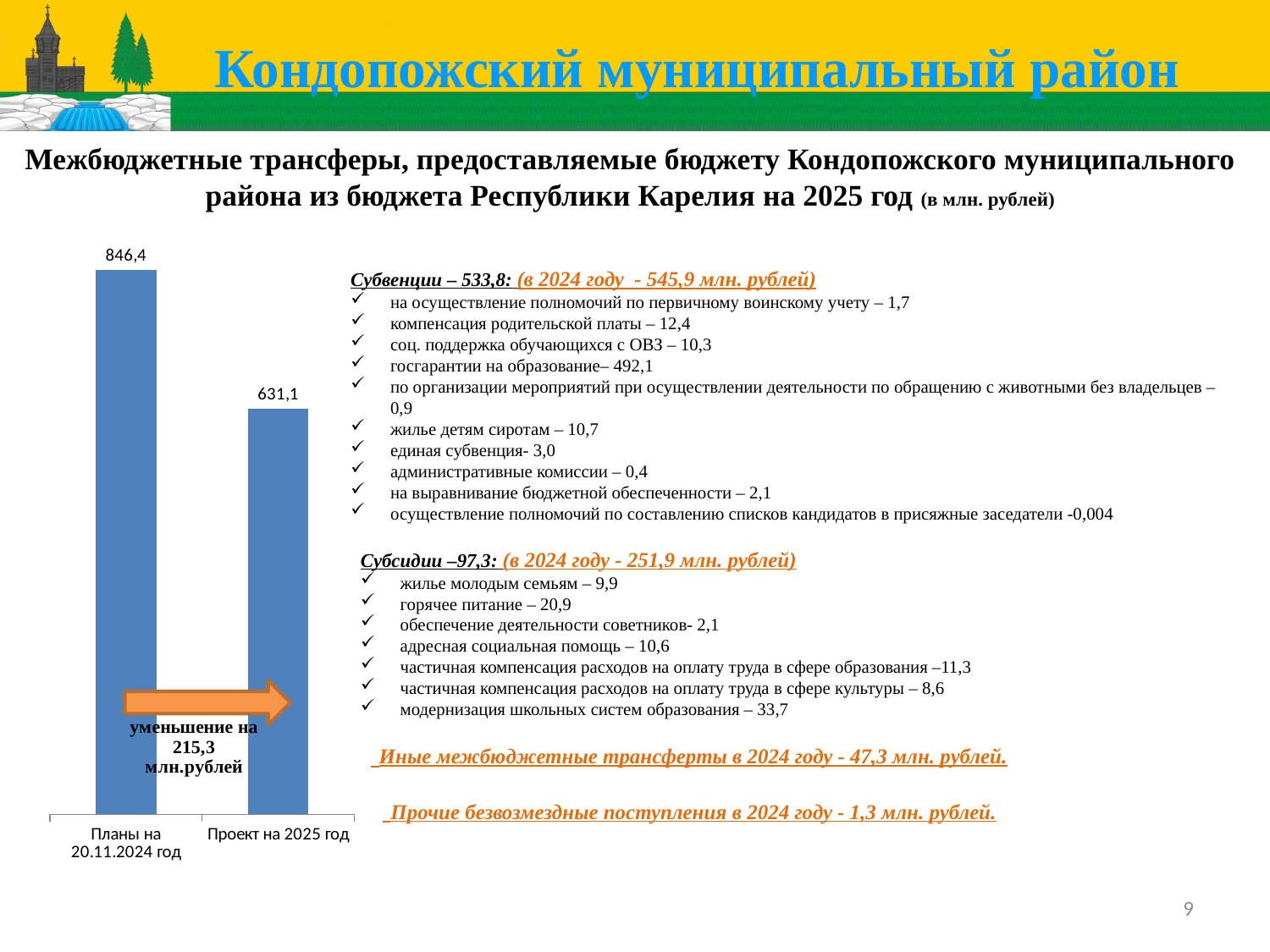
Which category has the highest value? Планы на 20.11.2024 год What is the value for "Проект на 2025 год"? 631,1 What kind of chart is shown on the slide? Bar chart What is the difference between the value for "Планы на 20.11.2024 год" and the value for "Проект на 2025 год"? 215,3 Do the values rise or fall from "Планы на 20.11.2024 год" to "Проект на 2025 год"? Fall Which category has the lowest value? Проект на 2025 год What decrease in million rubles is indicated by the arrow between the two bars? 215,3 млн.рублей What colour are the bars in the chart? Blue How many categories are shown in the chart? 2 Which is larger: the value for "Планы на 20.11.2024 год" or the value for "Проект на 2025 год"? Планы на 20.11.2024 год What is the value for "Планы на 20.11.2024 год"? 846,4